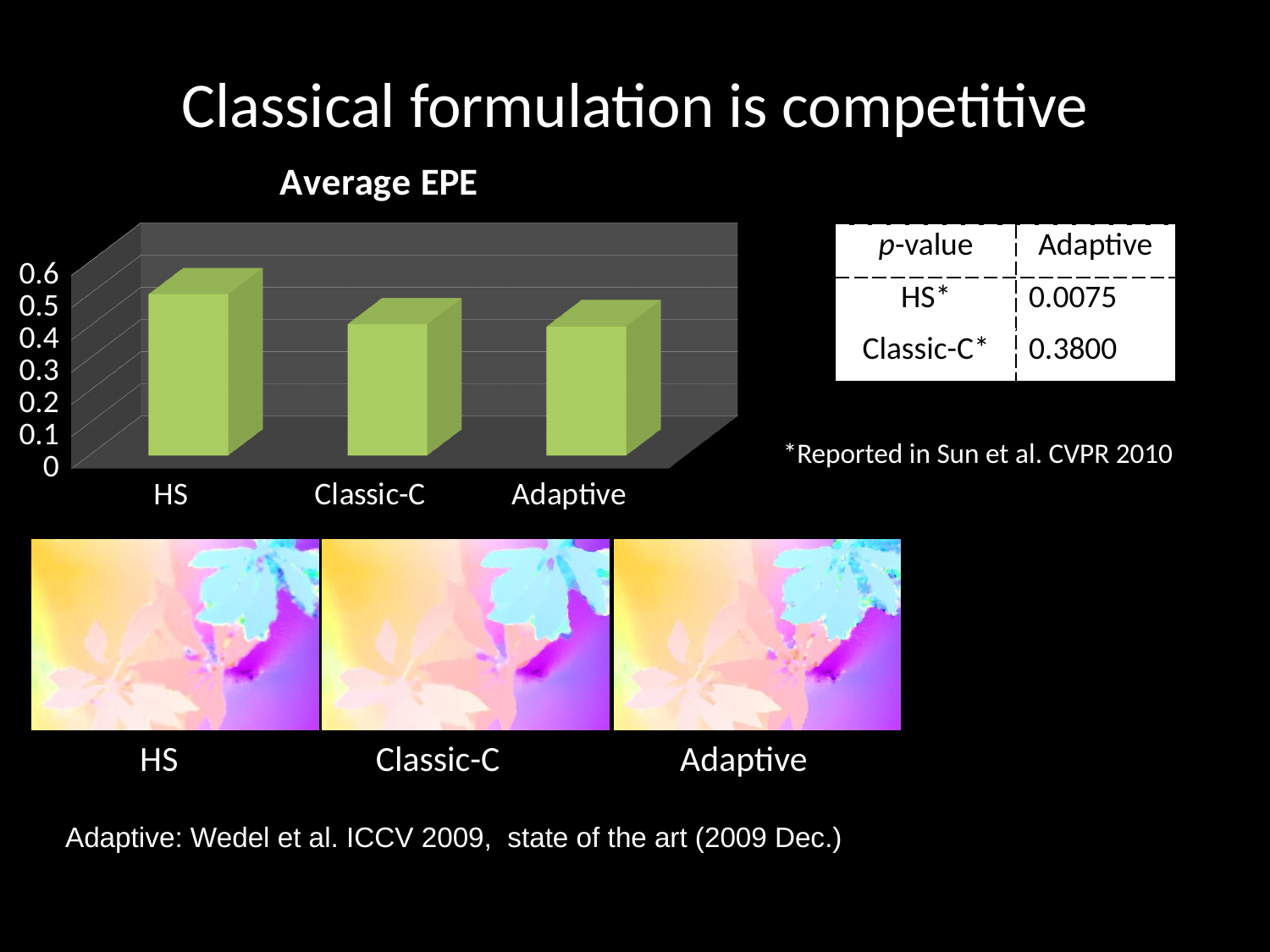
What is the highest tick value shown on the vertical axis of the chart? 0.6 Is the Average EPE value for HS greater or less than 0.3? greater Which category has the highest Average EPE? HS Is the Average EPE value for Adaptive greater or less than 0.6? less Is the Average EPE value for Classic-C greater or less than 0.6? less Which has the larger Average EPE, HS or Adaptive? HS What is the title of the chart? Average EPE How many categories are plotted in the Average EPE chart? 3 Which has the larger Average EPE, HS or Classic-C? HS What kind of chart is shown on the slide? bar chart What is the label of the third category on the x axis of the chart? Adaptive